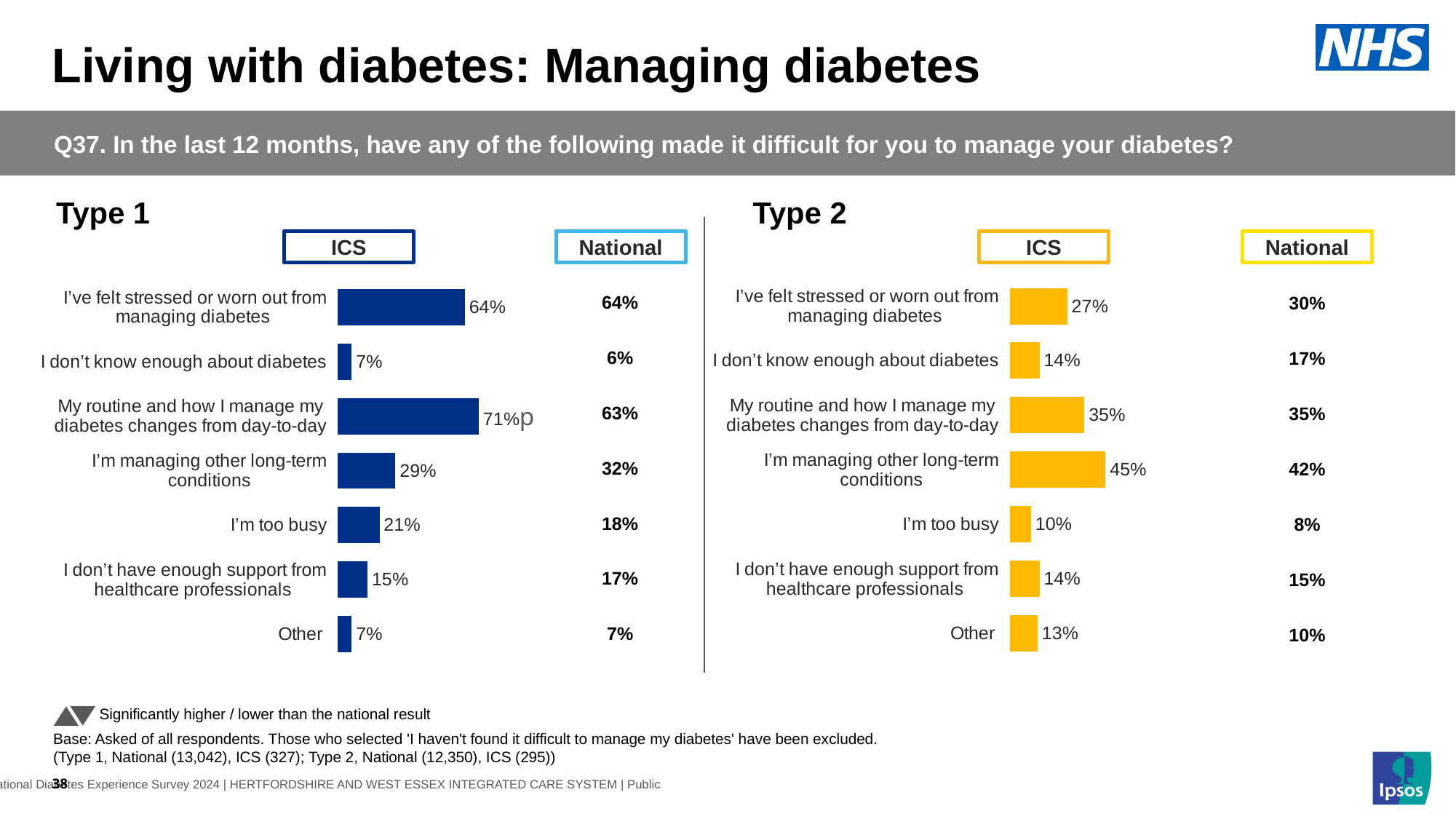
In the Type 2 chart, which is larger for 'I've felt stressed or worn out from managing diabetes': the ICS value or the National value? National In the Type 1 chart, what is the difference between the ICS value and the National value for 'My routine and how I manage my diabetes changes from day-to-day'? 8% In the Type 2 chart, which category has the lowest ICS value? I'm too busy In the Type 2 chart, what is the ICS value for 'I'm managing other long-term conditions'? 45% In the Type 1 chart, what is the ICS value for 'I've felt stressed or worn out from managing diabetes'? 64% In the Type 1 chart, how many categories are shown? 7 In the Type 2 chart, what is the National value for 'I'm too busy'? 8% What colour are the ICS bars in the Type 2 chart? Yellow In the Type 2 chart, what is the ICS value for 'Other'? 13% What kind of chart is used for the Type 2 ICS results? Bar chart In the Type 1 chart, which category has the highest ICS value? My routine and how I manage my diabetes changes from day-to-day In the Type 1 chart, what is the difference between the ICS values for 'I'm managing other long-term conditions' and 'I'm too busy'? 8%